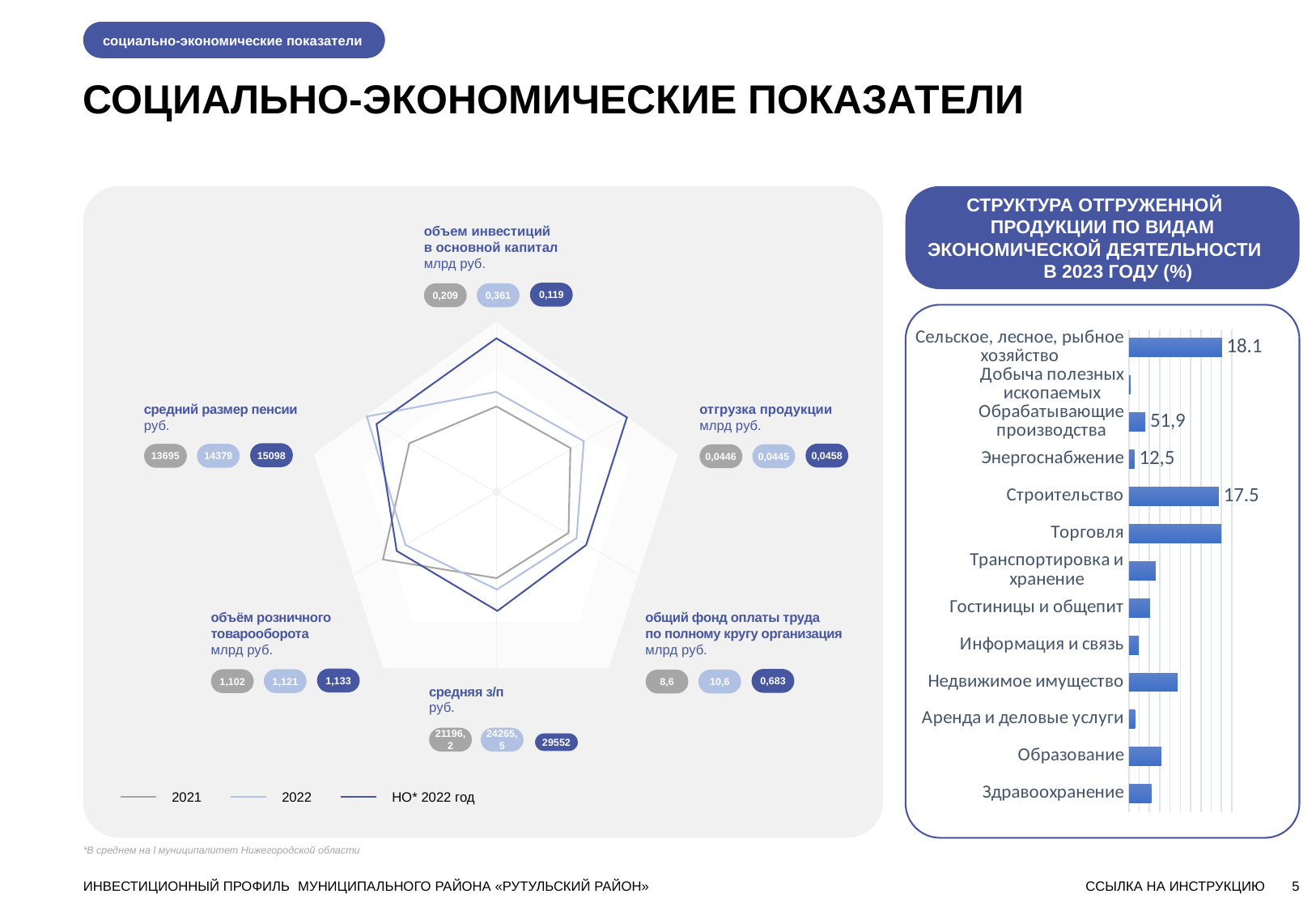
In the bar chart on the right, which is larger: «Транспортировка и хранение» or «Гостиницы и общепит»? Транспортировка и хранение In the bar chart on the right, what value is labelled for «Энергоснабжение»? 12,5 How many series does the legend of the radar chart on the left list? 3 In the bar chart on the right, how many categories (types of economic activity) are shown? 13 In the radar chart on the left, what is the difference between «средний размер пенсии» in 2022 (14379) and in 2021 (13695)? 684 What kind of chart is the chart on the right titled «Структура отгруженной продукции по видам экономической деятельности в 2023 году (%)»? bar chart In the radar chart on the left, what is the value of «средняя з/п» for «НО* 2022 год»? 29552 In the radar chart on the left, what is the value of «средний размер пенсии» for 2021? 13695 In the bar chart on the right, what is the value for «Строительство»? 17.5 What are the three legend entries of the radar chart on the left? 2021, 2022, НО* 2022 год In the bar chart on the right, which is larger: «Недвижимое имущество» or «Образование»? Недвижимое имущество In the bar chart on the right, what is the value for «Сельское, лесное, рыбное хозяйство»? 18.1